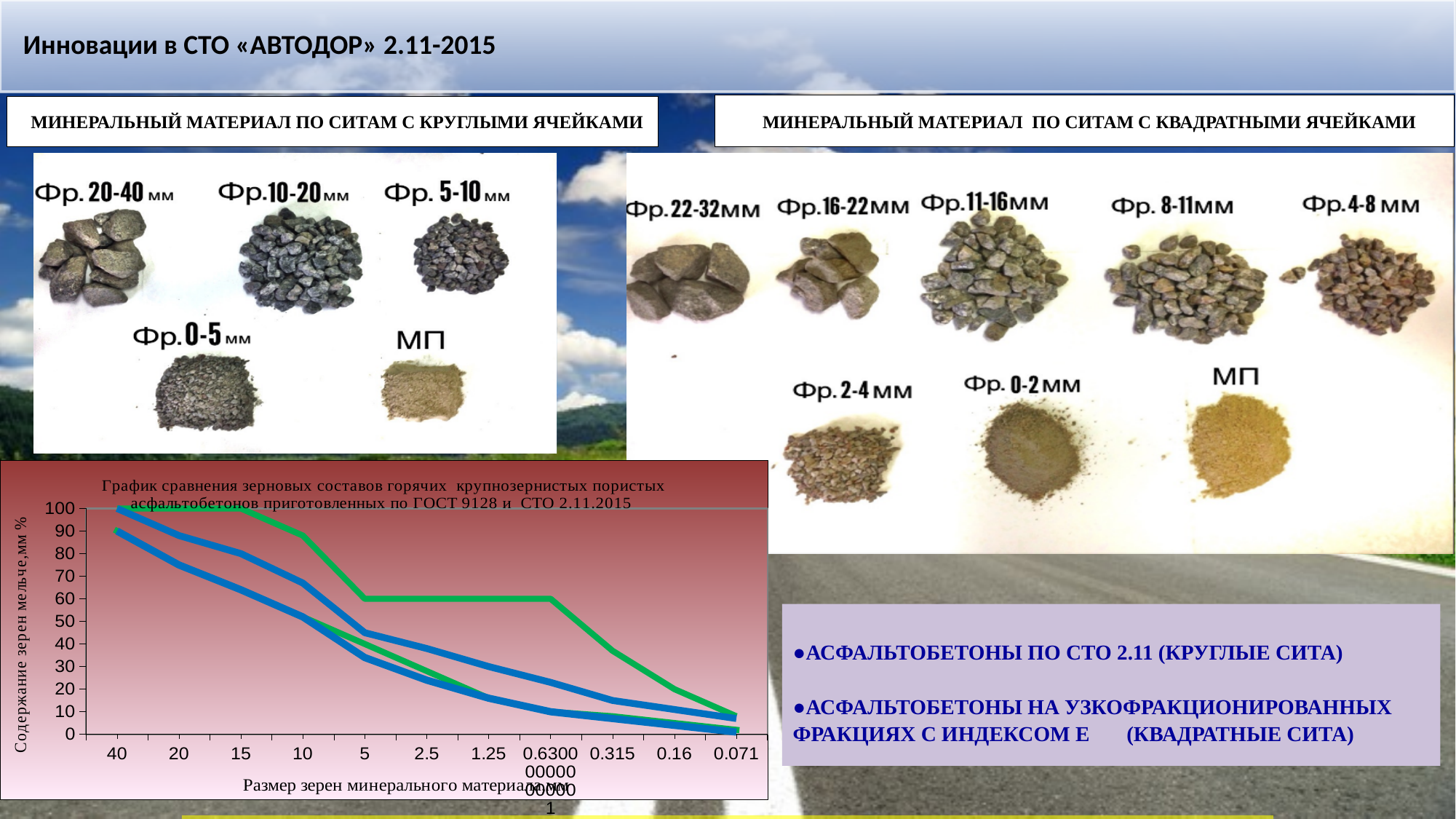
Are all the lines at x = 40 greater or less than 80? greater Are all the lines at x = 0.071 greater or less than 20? less Is the value of the topmost line at x = 5 greater or less than 50? greater Do the plotted lines rise or fall as you move from left to right along the x axis? fall What is the maximum value shown on the y axis of the chart? 100 What is the first (leftmost) category on the x axis of the chart? 40 What kind of chart is shown on the slide? line chart How many grain-size categories are marked along the x axis of the chart? 11 What is the last (rightmost) category on the x axis of the chart? 0.071